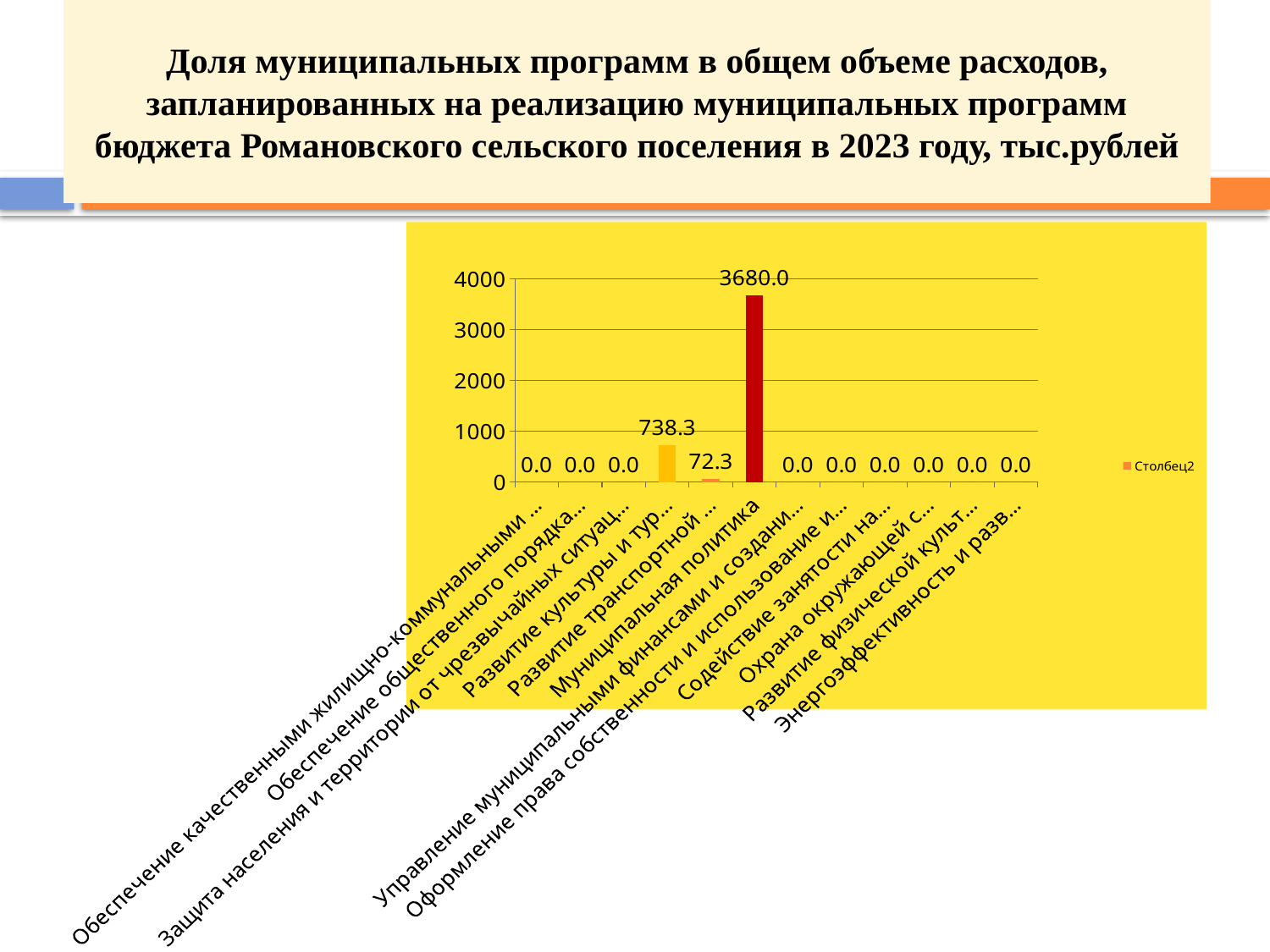
Which is larger: the value for the category beginning "Развитие культуры и тур..." or the value for the category beginning "Развитие транспортной ..."? Развитие культуры и тур... How many series does the legend list? 1 Is the value for Муниципальная политика greater or less than 3000? greater What is the difference between the value for the category beginning "Развитие культуры и тур..." and the value for the category beginning "Развитие транспортной ..."? 666.0 What is the difference between the value for Муниципальная политика and the value for the category beginning "Развитие культуры и тур..."? 2941.7 Which category has the highest value? Муниципальная политика What kind of chart is shown on the slide? bar chart What is the value for the category beginning "Развитие транспортной ..."? 72.3 How many categories have a value of 0.0? 9 What is the value for Муниципальная политика? 3680.0 What is the value for the category beginning "Развитие культуры и тур..."? 738.3 How many categories are shown on the x axis? 12